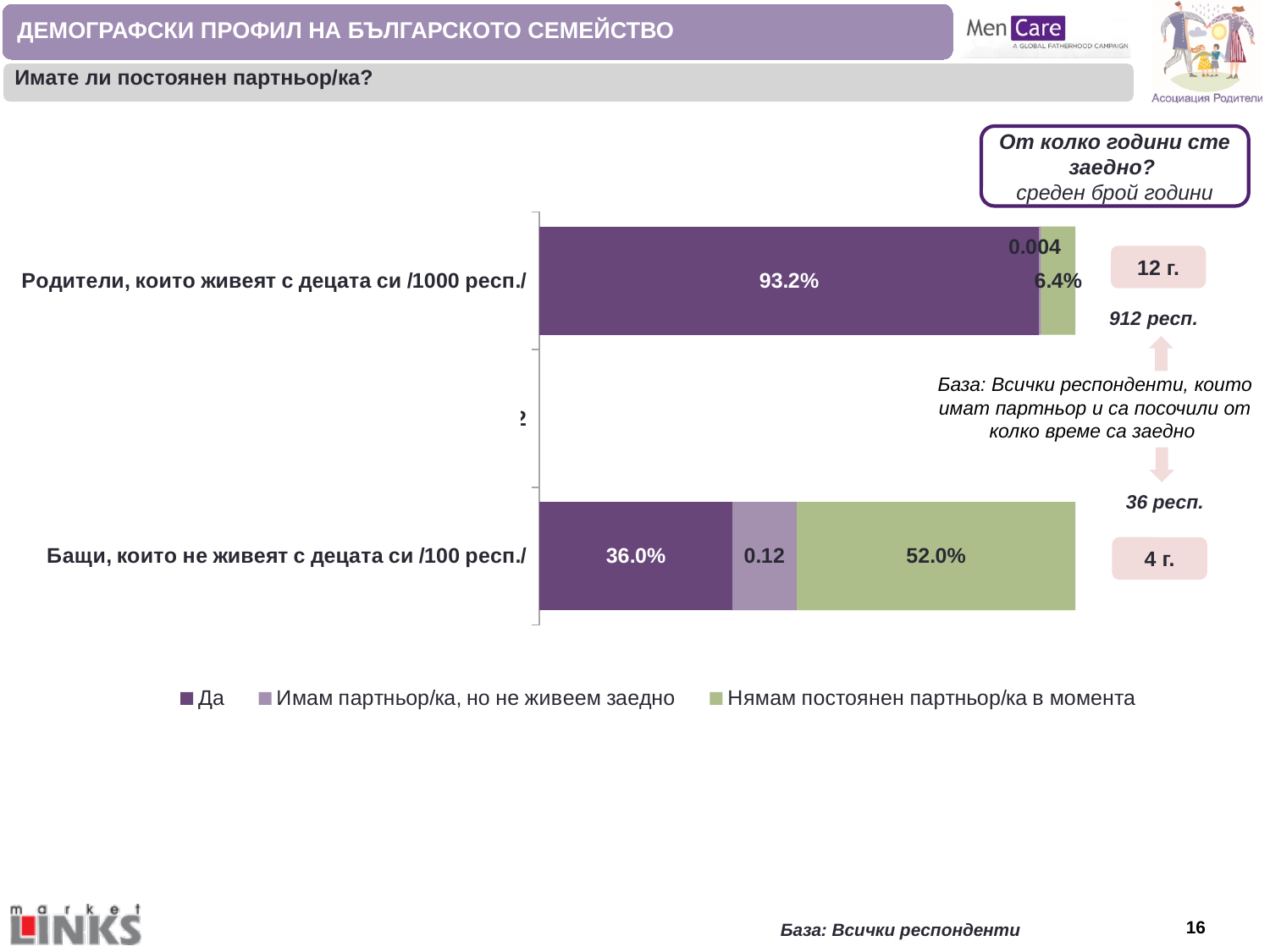
What is the difference between the "Нямам постоянен партньор/ка в момента" values for "Бащи, които не живеят с децата си" and "Родители, които живеят с децата си"? 45.6% What kind of chart is shown on the slide? Stacked bar chart What is the value for "Имам партньор/ка, но не живеем заедно" for "Родители, които живеят с децата си /1000 респ./"? 0.004 What is the value for "Да" for "Бащи, които не живеят с децата си /100 респ./"? 36.0% What is the value for "Нямам постоянен партньор/ка в момента" for "Бащи, които не живеят с децата си /100 респ./"? 52.0% What is the value for "Нямам постоянен партньор/ка в момента" for "Родители, които живеят с децата си /1000 респ./"? 6.4% Which category has the larger value for "Да": "Родители, които живеят с децата си" or "Бащи, които не живеят с децата си"? Родители, които живеят с децата си /1000 респ./ How many series does the legend list? 3 What is the difference between the "Да" values for "Родители, които живеят с децата си" and "Бащи, които не живеят с децата си"? 57.2% Which series has the largest value for "Бащи, които не живеят с децата си /100 респ./"? Нямам постоянен партньор/ка в момента What is the value for "Да" for "Родители, които живеят с децата си /1000 респ./"? 93.2% What is the value for "Имам партньор/ка, но не живеем заедно" for "Бащи, които не живеят с децата си /100 респ./"? 0.12